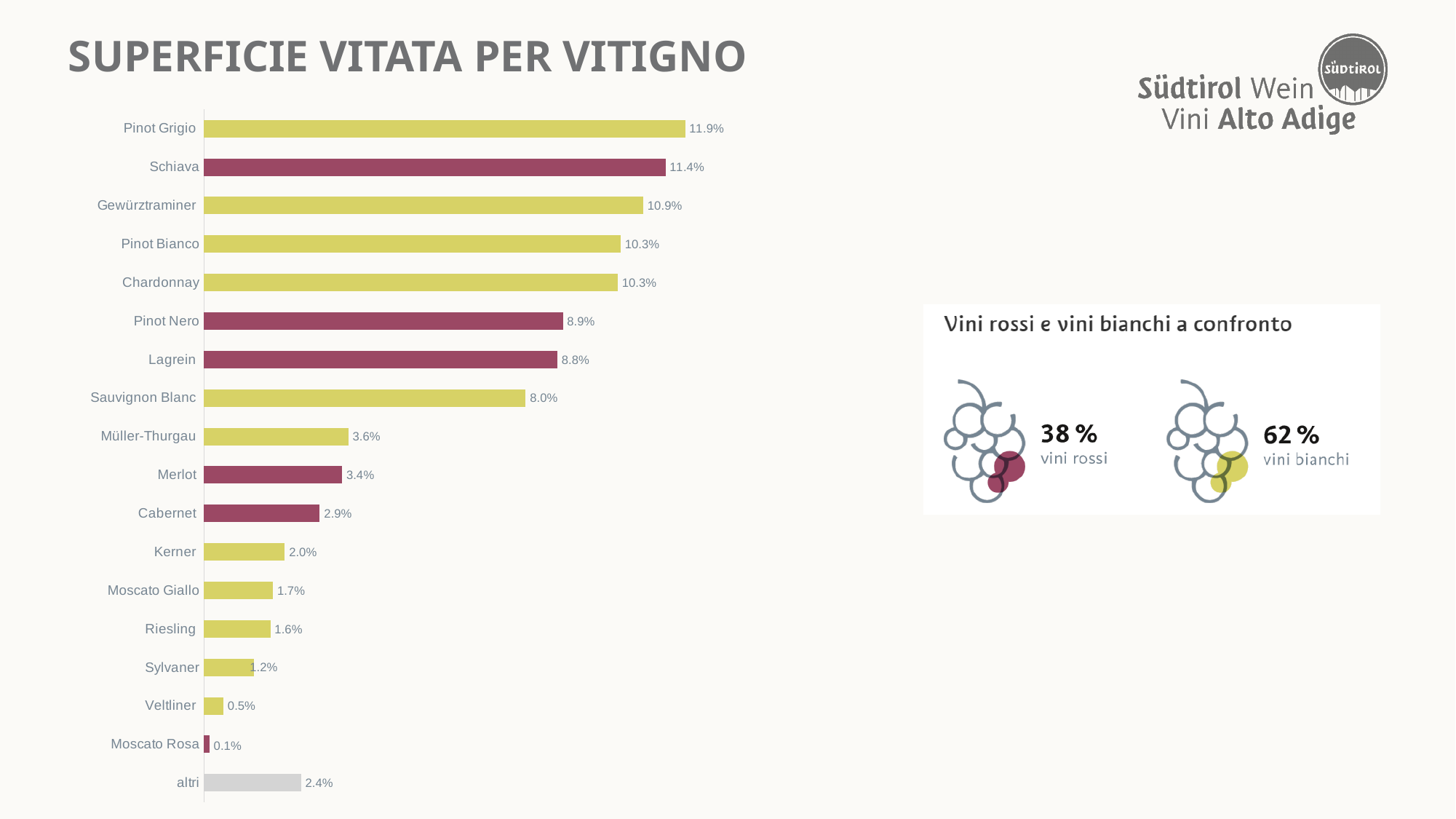
Which grape variety has the lowest value? Moscato Rosa What is the value for Lagrein? 8.8% What is the value for altri? 2.4% Which grape variety has the highest value? Pinot Grigio What is the value for Kerner? 2.0% How many categories are shown in the bar chart? 18 What is the value for Pinot Grigio? 11.9% Which is larger, the value for Sauvignon Blanc or the value for Lagrein? Lagrein What is the value for Schiava? 11.4% What is the title of the slide? SUPERFICIE VITATA PER VITIGNO What is the difference between the values for Pinot Grigio and Schiava? 0.5% What type of chart is shown on the slide? bar chart